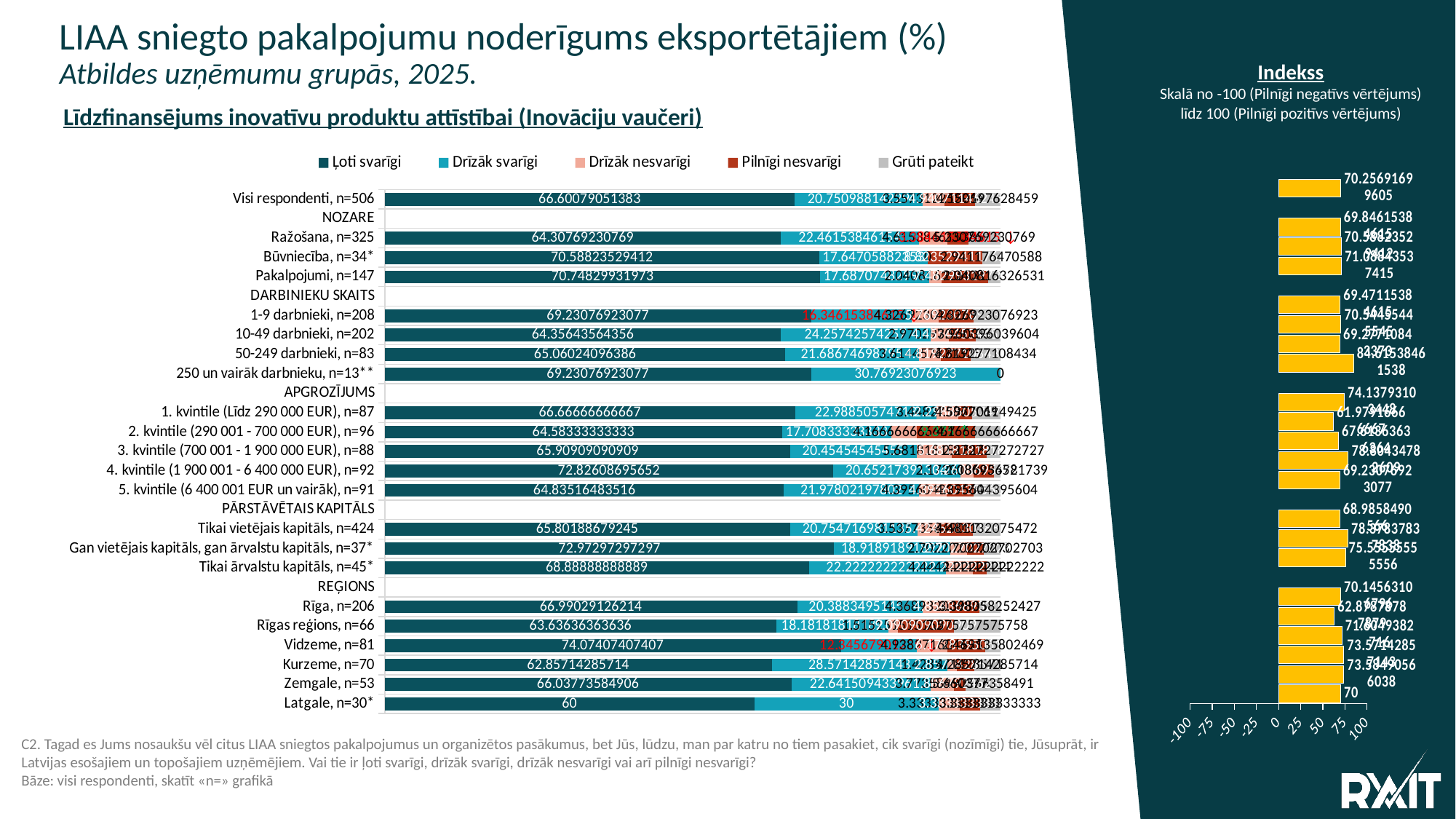
In the main chart, what is the 'Ļoti svarīgi' value for 'Vidzeme, n=81'? 74.07407407407 In the main chart, what is the 'Drīzāk svarīgi' value for 'Latgale, n=30*'? 30 What kind of chart is the main chart on the left of the slide? bar chart In the main chart, what is the 'Ļoti svarīgi' value for 'Visi respondenti, n=506'? 66.60079051383 In the main chart, what is the difference between the 'Ļoti svarīgi' and 'Drīzāk svarīgi' values for 'Latgale, n=30*'? 30 In the main chart, which has a larger 'Ļoti svarīgi' value: 'Būvniecība, n=34*' or 'Ražošana, n=325'? Būvniecība, n=34* In the main chart, which category has the lowest 'Ļoti svarīgi' value? Latgale, n=30* In the main chart, what is the 'Ļoti svarīgi' value for 'Latgale, n=30*'? 60 How many series does the legend of the main chart list? 5 In the main chart, which region under REĢIONS has the highest 'Ļoti svarīgi' value? Vidzeme, n=81 In the 'Indekss' chart on the right, what is the index value for 'Latgale, n=30*' (the bottom bar)? 70 In the main chart, what is the 'Drīzāk svarīgi' value for '250 un vairāk darbnieku, n=13**'? 30.76923076923